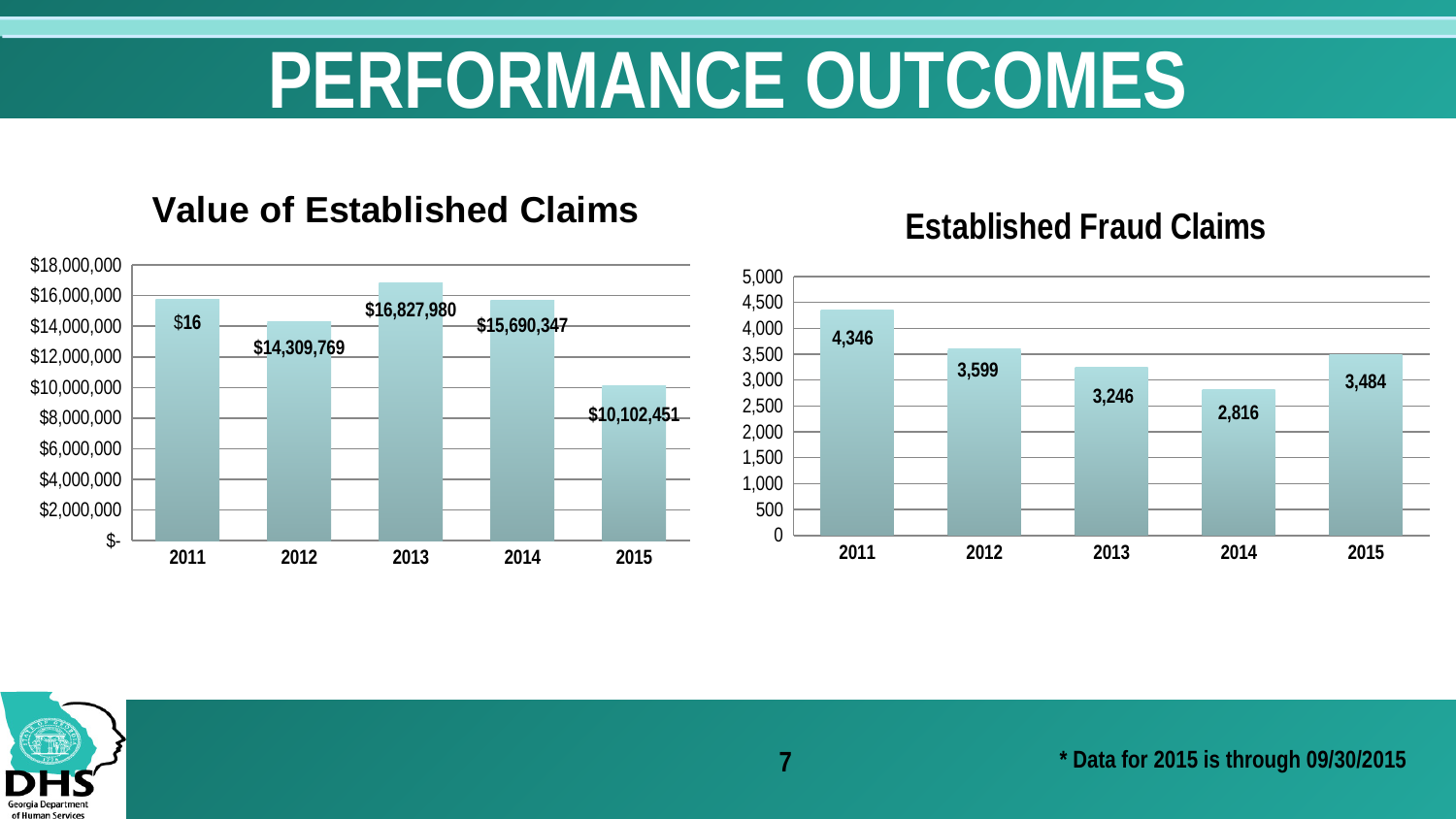
In the Value of Established Claims chart, is the value for 2011 greater or less than $14,000,000? greater In the Established Fraud Claims chart, which year has the highest number of claims? 2011 How many years are shown on the x axis of the Established Fraud Claims chart? 5 In the Established Fraud Claims chart, how many claims were established in 2014? 2,816 In the Value of Established Claims chart, which year has the highest value? 2013 In the Established Fraud Claims chart, which year has the lowest number of claims? 2014 In the Value of Established Claims chart, what is the value for 2015? $10,102,451 In the Value of Established Claims chart, what is the value for 2013? $16,827,980 In the Established Fraud Claims chart, which is larger, the value for 2012 or the value for 2015? 2012 In the Established Fraud Claims chart, what is the difference between the 2011 and 2012 values? 747 In the Value of Established Claims chart, what is the difference between the 2014 and 2012 values? $1,380,578 In the Value of Established Claims chart, which year has the lowest value? 2015